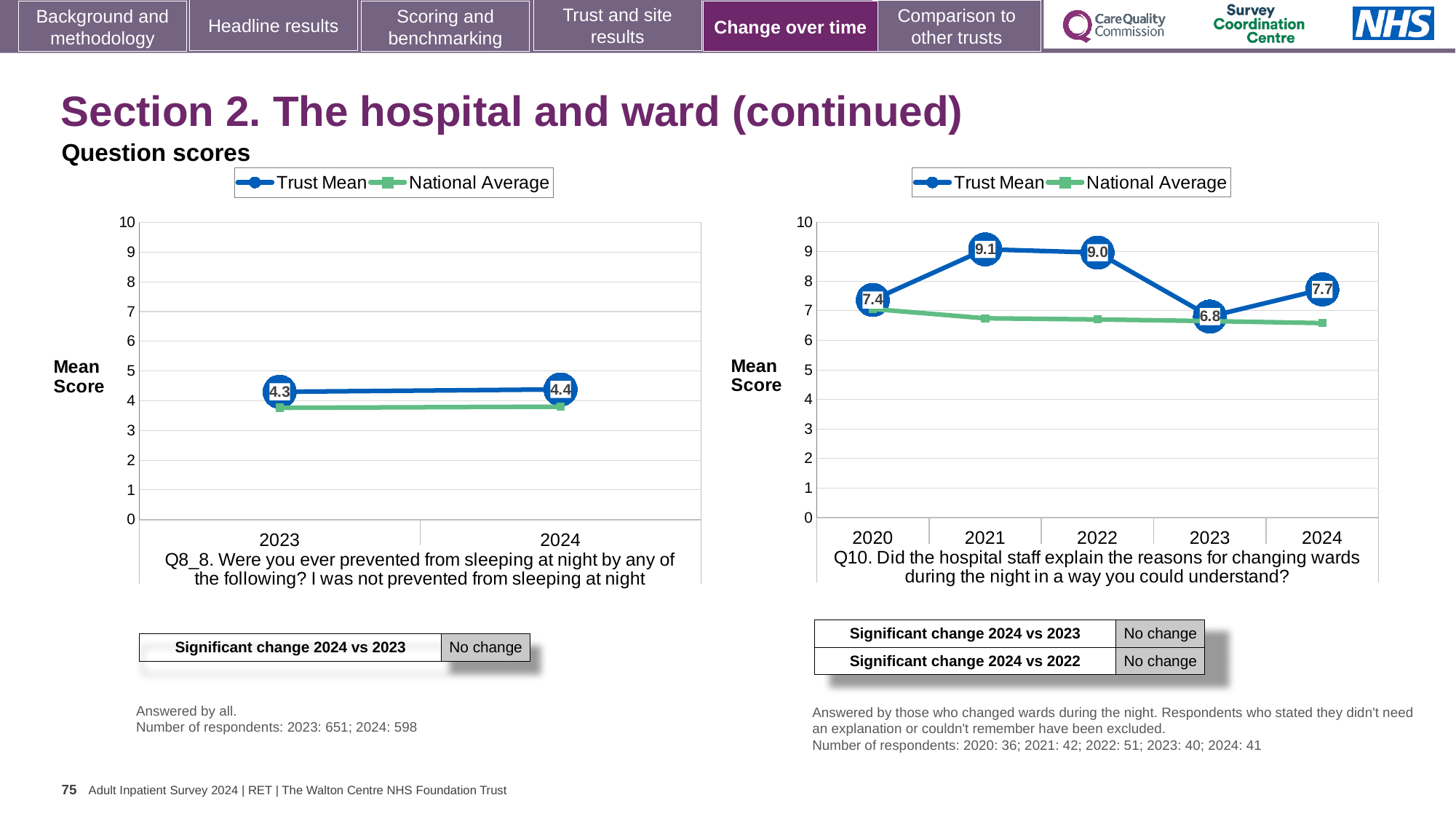
In the Q10 chart on the right, what is the Trust Mean score for 2021? 9.1 In the Q8_8 chart on the left, is the National Average value for 2024 greater or less than 4? less In the Q8_8 chart on the left, what is the Trust Mean score for 2024? 4.4 In the Q10 chart on the right, what is the difference between the Trust Mean scores for 2021 and 2023? 2.3 How many series does the legend of the Q8_8 chart on the left list? 2 In the Q10 chart on the right, which year has the highest Trust Mean score? 2021 In the Q8_8 chart on the left, what is the Trust Mean score for 2023? 4.3 How many years are shown on the x axis of the Q10 chart on the right? 5 In the Q10 chart on the right, is the Trust Mean score higher in 2020 or in 2024? 2024 In the Q10 chart on the right, what is the Trust Mean score for 2024? 7.7 In the Q10 chart on the right, which year has the lowest Trust Mean score? 2023 What kind of chart is the Q10 chart on the right? Line chart